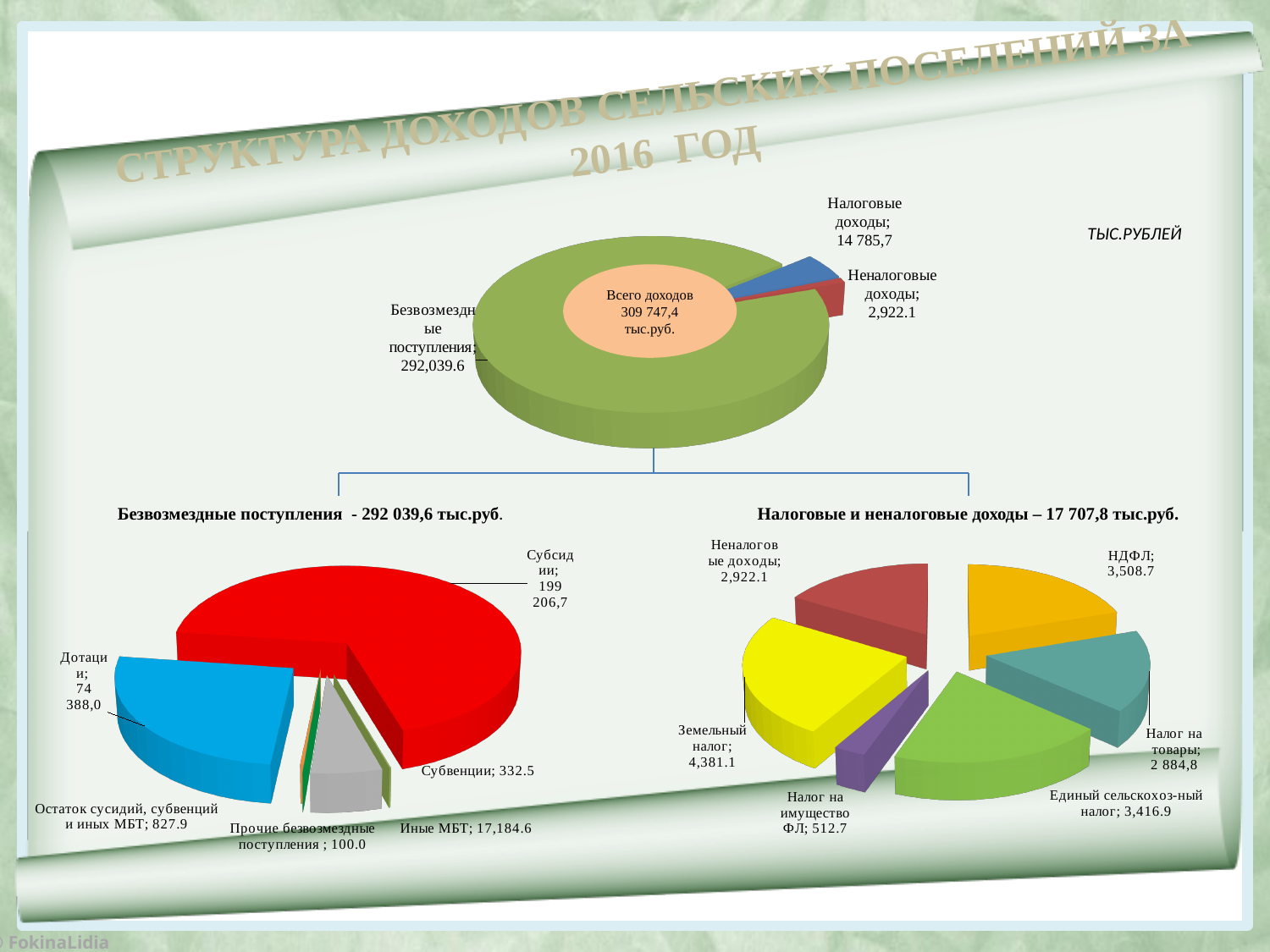
On the bottom-left pie chart (Безвозмездные поступления), how many slices are there? 6 On the top doughnut chart, how many categories are plotted? 3 On the bottom-right pie chart (Налоговые и неналоговые доходы), which is larger: НДФЛ or Налог на имущество ФЛ? НДФЛ On the bottom-left pie chart (Безвозмездные поступления), what is the difference between Иные МБТ and Субвенции? 16,852.1 On the top doughnut chart, what total is shown in the centre? Всего доходов 309 747,4 тыс.руб. On the bottom-left pie chart (Безвозмездные поступления), which category has the smallest value? Прочие безвозмездные поступления On the bottom-right pie chart (Налоговые и неналоговые доходы), what is the value for Земельный налог? 4,381.1 What type of chart is the bottom-right chart (Налоговые и неналоговые доходы)? Pie chart On the top doughnut chart, which category has the largest value? Безвозмездные поступления On the bottom-left pie chart (Безвозмездные поступления), what is the value for Дотации? 74 388,0 On the top doughnut chart, what is the value for Налоговые доходы? 14 785,7 On the bottom-right pie chart (Налоговые и неналоговые доходы), which category has the smallest value? Налог на имущество ФЛ